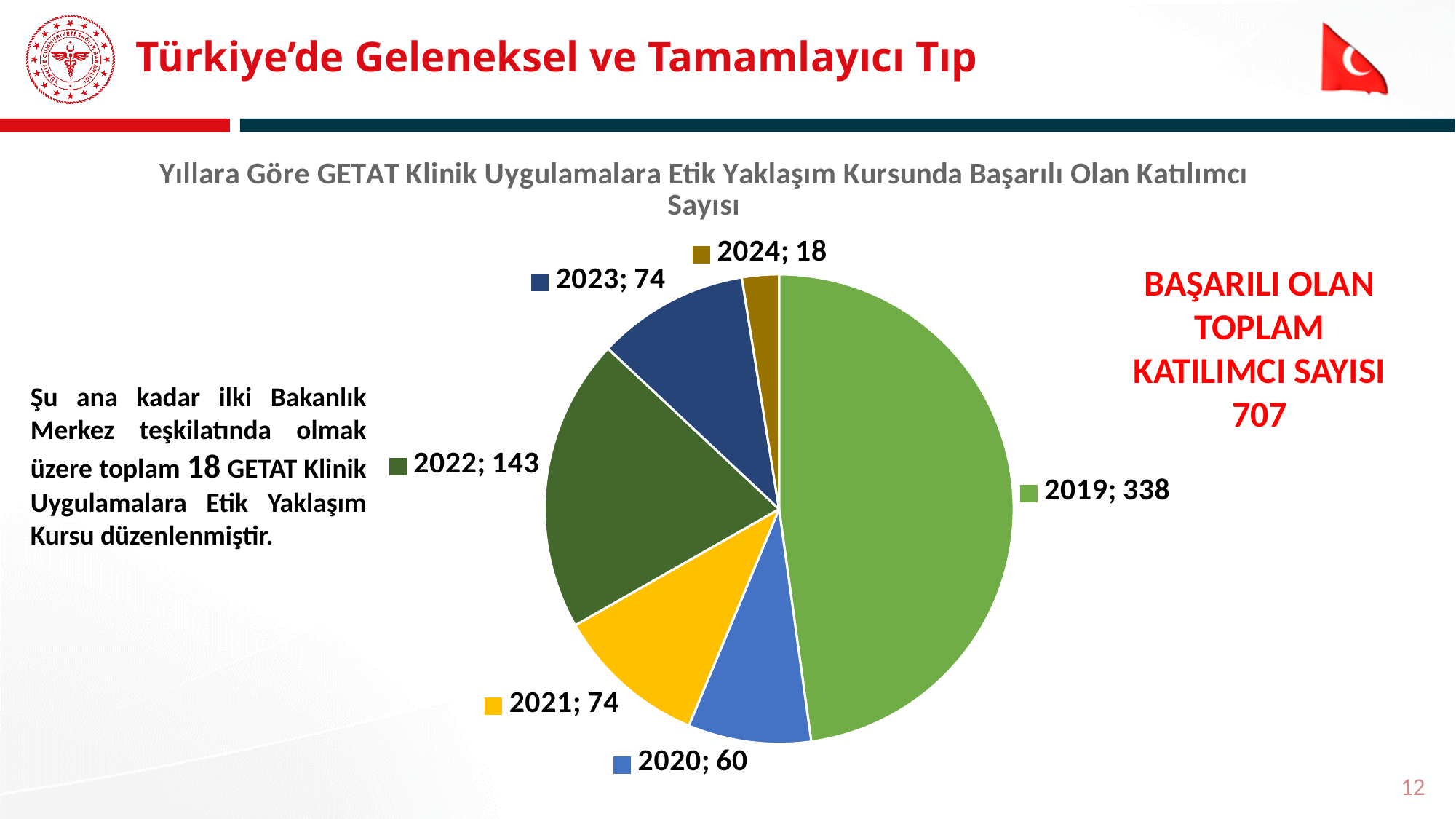
What type of chart is shown on the slide? pie chart What is the total number of successful participants across all years shown? 707 What is the value shown for 2024? 18 Which year has the smallest slice of the pie? 2024 What is the value shown for 2022? 143 What is the difference between the values for 2021 and 2020? 14 Which is larger, the value for 2022 or the value for 2023? 2022 Which year has the largest slice of the pie? 2019 What is the value shown for 2020? 60 What is the difference between the values for 2019 and 2022? 195 How many successful participants are shown for 2019? 338 How many years (slices) does the pie chart show? 6